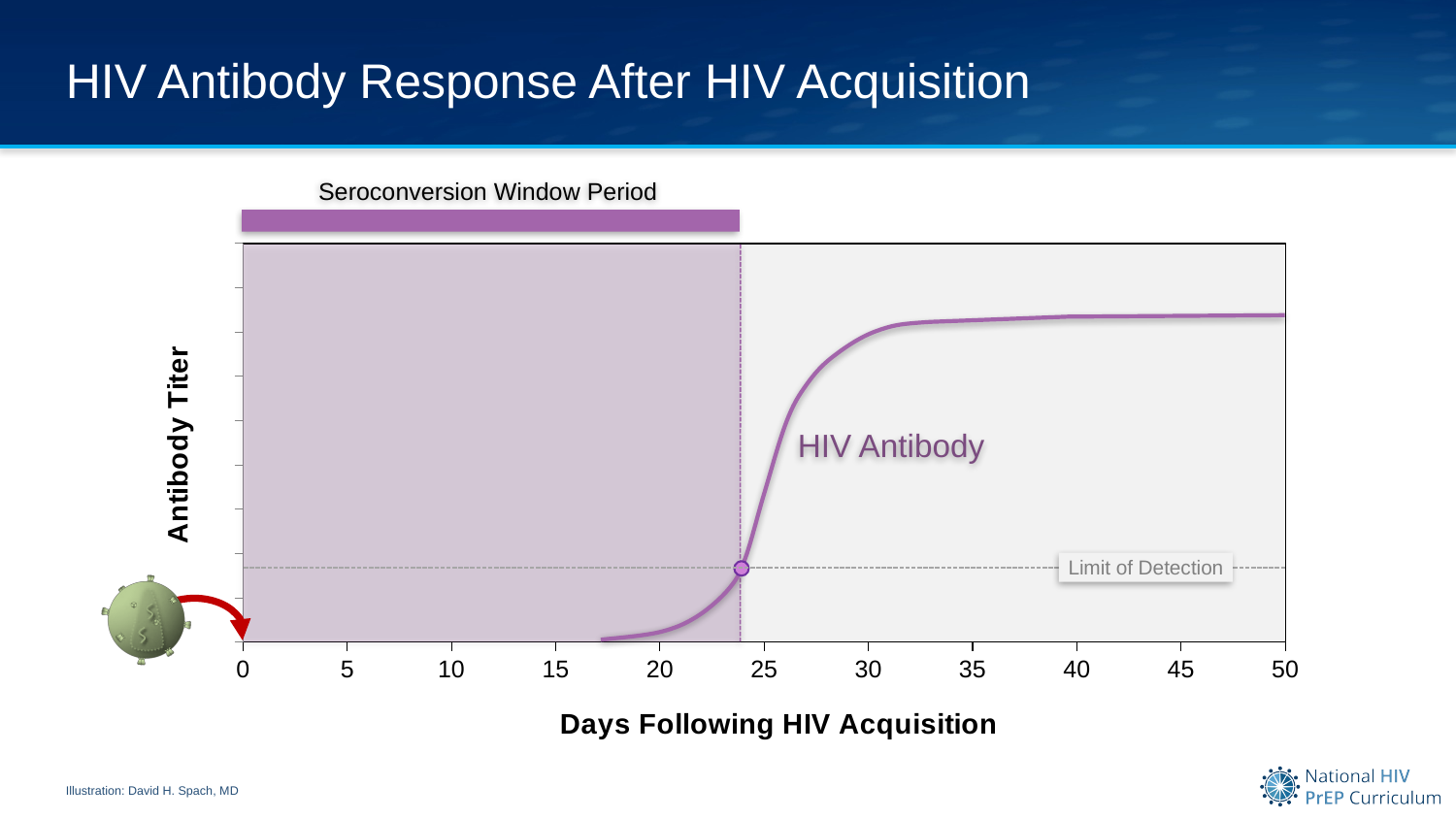
What is the label of the x axis? Days Following HIV Acquisition What is the title of the slide's chart? HIV Antibody Response After HIV Acquisition What is the name of the shaded period at the start of the chart? Seroconversion Window Period What is the highest value shown on the x axis? 50 Is the day on which the HIV Antibody curve crosses the Limit of Detection greater or less than 20? greater How many tick labels are shown on the x axis? 11 What does the horizontal dashed line on the chart represent? Limit of Detection What kind of chart is shown on the slide? line chart Does the HIV Antibody curve rise or fall as days following HIV acquisition increase? rise What is the interval between consecutive tick labels on the x axis? 5 What is the label of the y axis? Antibody Titer Is the day on which the HIV Antibody curve crosses the Limit of Detection greater or less than 30? less